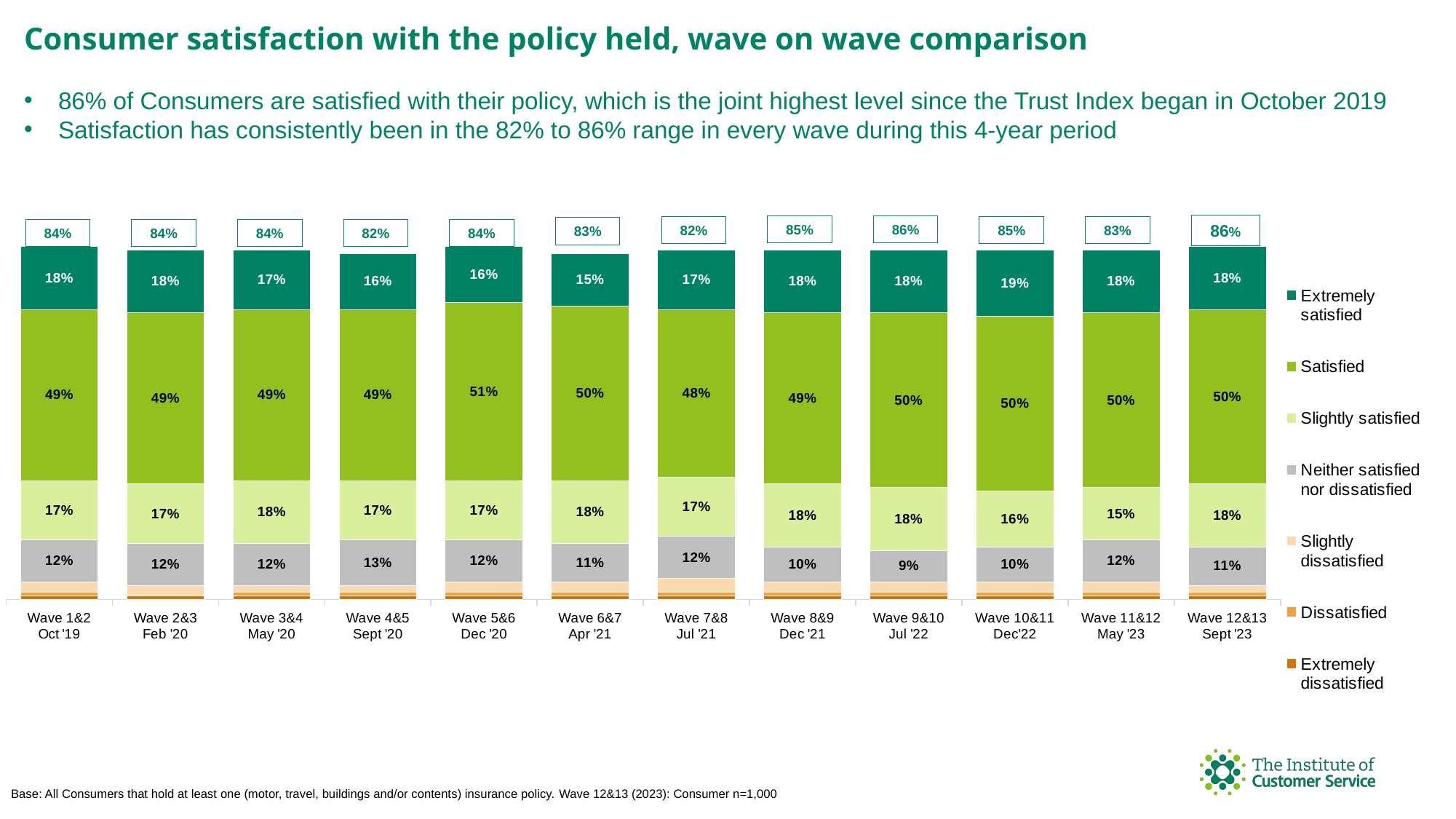
Which wave has the highest 'Satisfied' percentage? Wave 5&6 Dec '20 Which wave has the larger 'Slightly satisfied' value, Wave 11&12 May '23 or Wave 12&13 Sept '23? Wave 12&13 Sept '23 How many waves (bars) are shown on the chart? 12 How many series does the legend list? 7 What type of chart is shown on the slide? Stacked bar chart Which wave has the lowest 'Extremely satisfied' percentage? Wave 6&7 Apr '21 In Wave 12&13 Sept '23, how many percentage points higher is 'Satisfied' than 'Extremely satisfied'? 32 percentage points What is the 'Neither satisfied nor dissatisfied' value for Wave 9&10 Jul '22? 9% What is the 'Extremely satisfied' value for Wave 10&11 Dec'22? 19% What percentage of consumers were 'Satisfied' in Wave 5&6 Dec '20? 51% What overall satisfaction figure is shown in the box above the Wave 4&5 Sept '20 bar? 82% Which series is shown in dark green at the top of each bar? Extremely satisfied